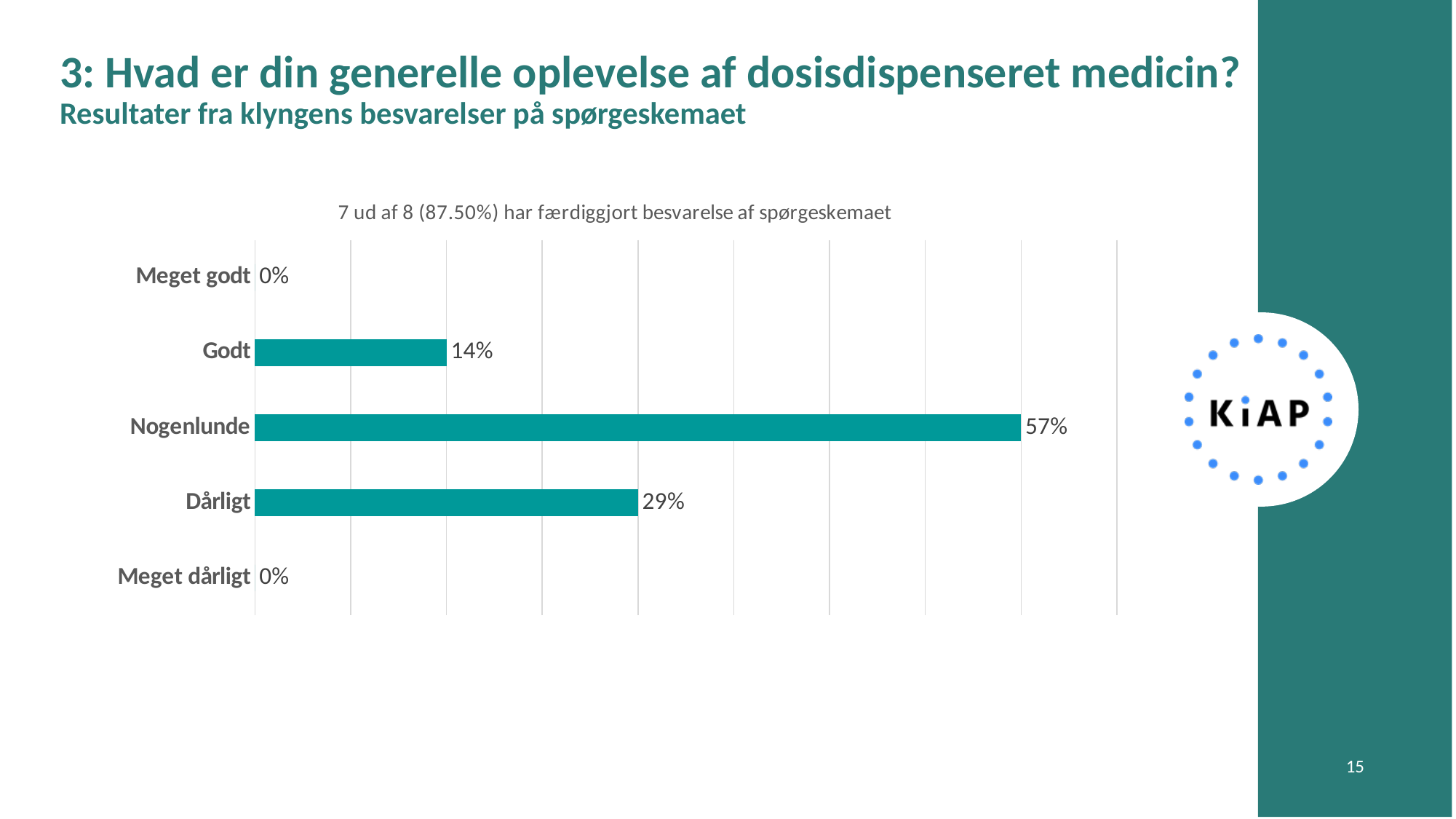
What is the value for Nogenlunde? 57% What is the value for Meget godt? 0% What is the difference between the values for Nogenlunde and Dårligt? 28% Which is larger, the value for Godt or the value for Dårligt? Dårligt What is the value for Dårligt? 29% What is the difference between the values for Dårligt and Godt? 15% What kind of chart is shown on the slide? Bar chart What is the text shown above the chart? 7 ud af 8 (87.50%) har færdiggjort besvarelse af spørgeskemaet Which category has the highest value? Nogenlunde What is the value for Godt? 14% How many categories have a value of 0%? 2 How many categories are shown in the chart? 5